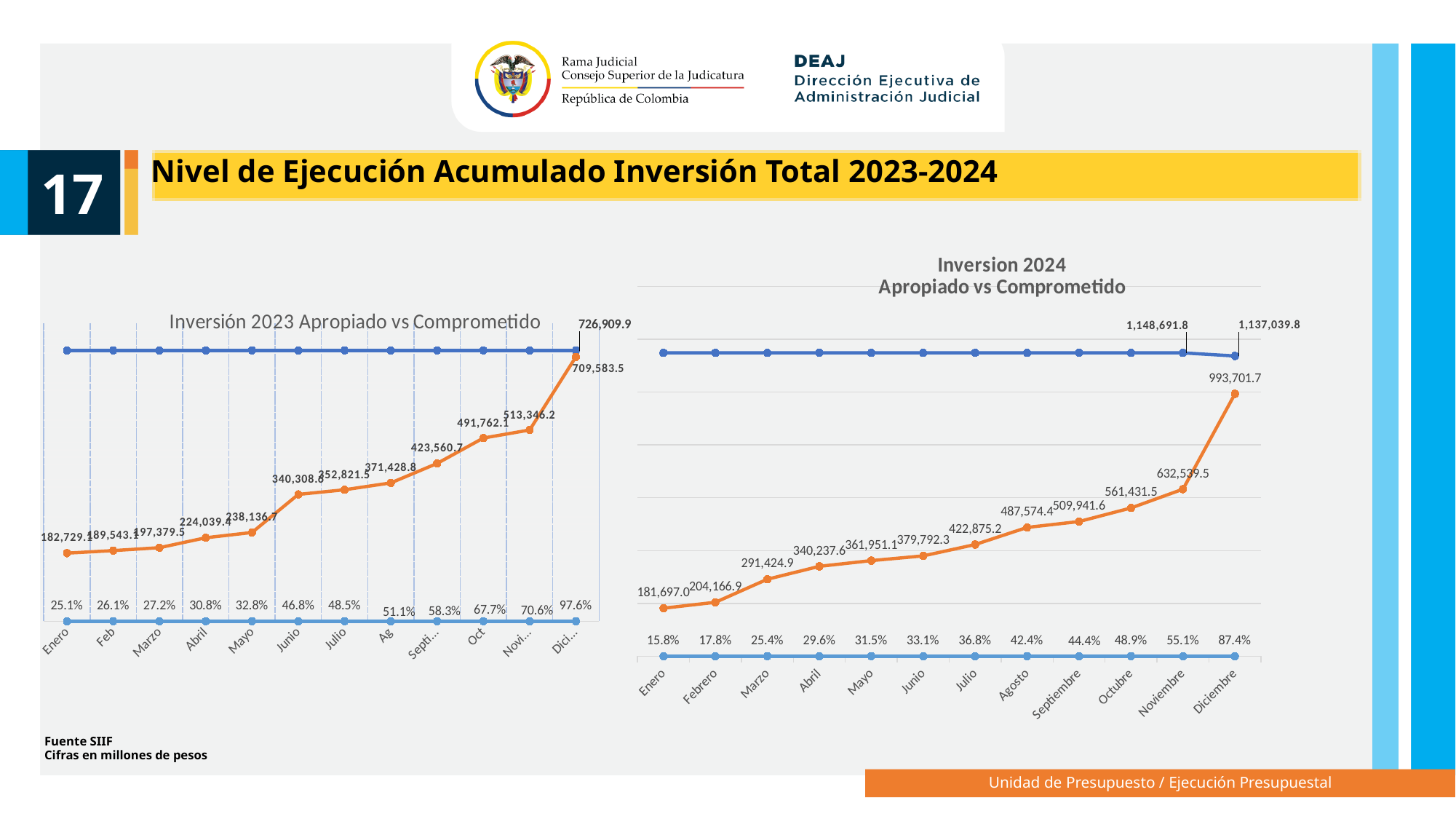
In the Inversion 2024 Apropiado vs Comprometido chart, how many months are plotted on the x axis? 12 In the Inversion 2024 Apropiado vs Comprometido chart, what is the value of the blue line for Noviembre? 1,148,691.8 What kind of chart is the Inversión 2023 Apropiado vs Comprometido chart? line chart In the Inversión 2023 Apropiado vs Comprometido chart, what is the difference between the orange line values for Junio and Mayo? 102,171.9 In the Inversion 2024 Apropiado vs Comprometido chart, what is the value of the orange line for Diciembre? 993,701.7 In the Inversión 2023 Apropiado vs Comprometido chart, what is the value labelled on the blue line at the end of the year? 726,909.9 In the Inversión 2023 Apropiado vs Comprometido chart, what is the value of the orange line for Oct? 491,762.1 In the Inversion 2024 Apropiado vs Comprometido chart, does the orange line rise or fall from Enero to Diciembre? rise In the Inversion 2024 Apropiado vs Comprometido chart, which month has the lowest orange line value? Enero In the Inversion 2024 Apropiado vs Comprometido chart, what percentage is shown for Agosto? 42.4% In the Inversión 2023 Apropiado vs Comprometido chart, what is the value of the orange line for Enero? 182,729.1 In the Inversión 2023 Apropiado vs Comprometido chart, what percentage is shown for Dici...? 97.6%